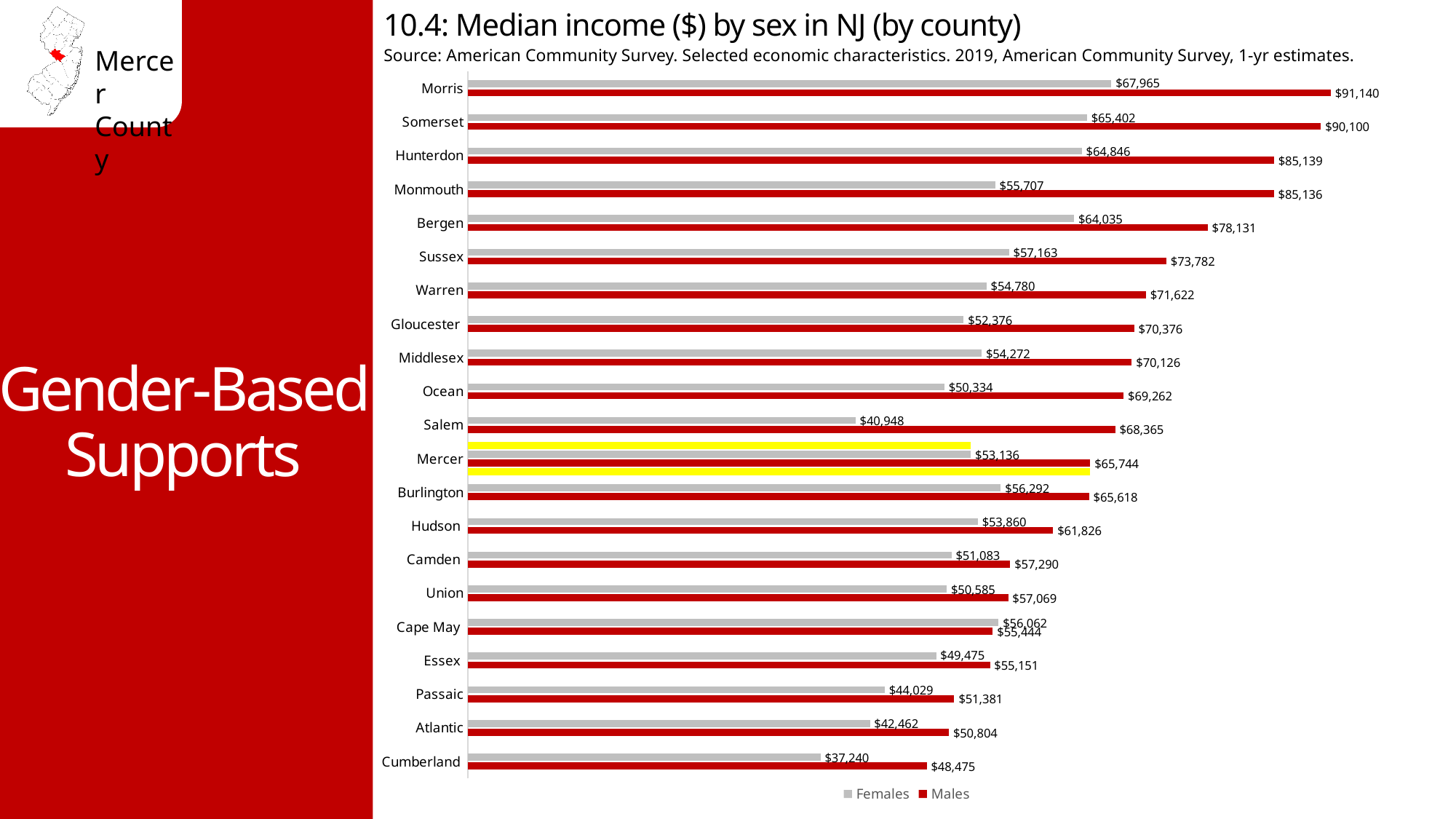
How many series does the legend list? 2 Which county's bars are highlighted in yellow on the chart? Mercer Which county has the highest median income for males? Morris What is the difference between the male and female median income in Mercer County? $12,608 What is the median income for males in Mercer County? $65,744 What is the median income for females in Mercer County? $53,136 Which county has the lowest median income for females? Cumberland Which is higher: the male median income in Hunterdon or in Monmouth? Hunterdon What type of chart is shown on the slide? Bar chart What is the median income for females in Salem County? $40,948 In Cape May County, which is higher: the female or the male median income? Females How many counties are shown in the chart? 21